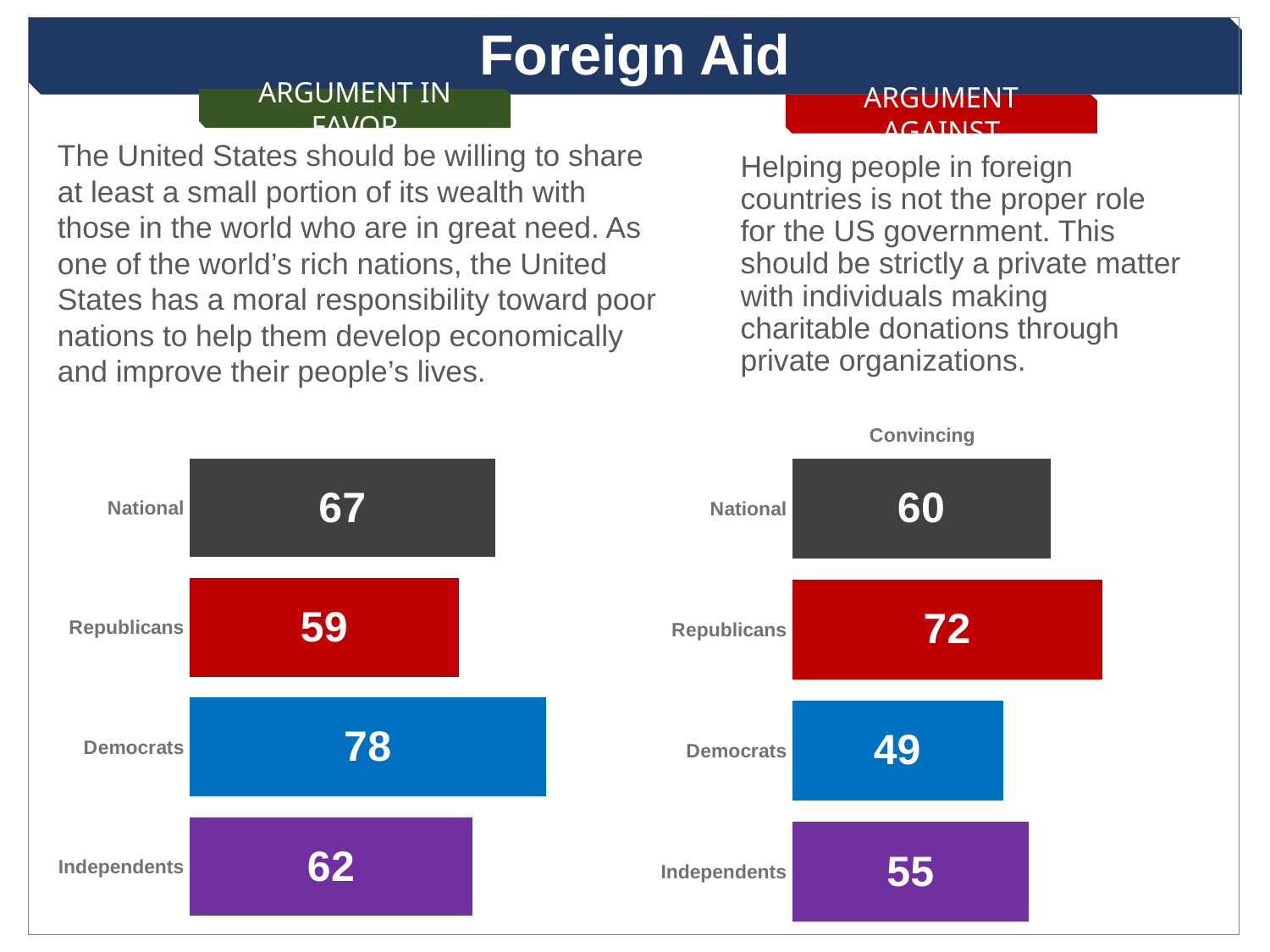
In the right chart (Argument Against), what is the value for Republicans? 72 In the right chart (Argument Against), what is the difference between the Republicans value and the Democrats value? 23 Which is larger: the Independents value in the left chart (Argument in Favor) or the Independents value in the right chart (Argument Against)? Left chart (Argument in Favor), 62 In the left chart (Argument in Favor), what is the difference between the Democrats value and the National value? 11 In the left chart (Argument in Favor), what is the value for Democrats? 78 What kind of chart is the left chart (Argument in Favor)? Bar chart In the left chart (Argument in Favor), what is the National value? 67 In the right chart (Argument Against), which category has the lowest value? Democrats In the right chart (Argument Against), what is the value for Independents? 55 In the left chart (Argument in Favor), which category has the highest value? Democrats How many categories are shown in the right chart (Argument Against)? 4 In the left chart (Argument in Favor), which category has the lowest value? Republicans